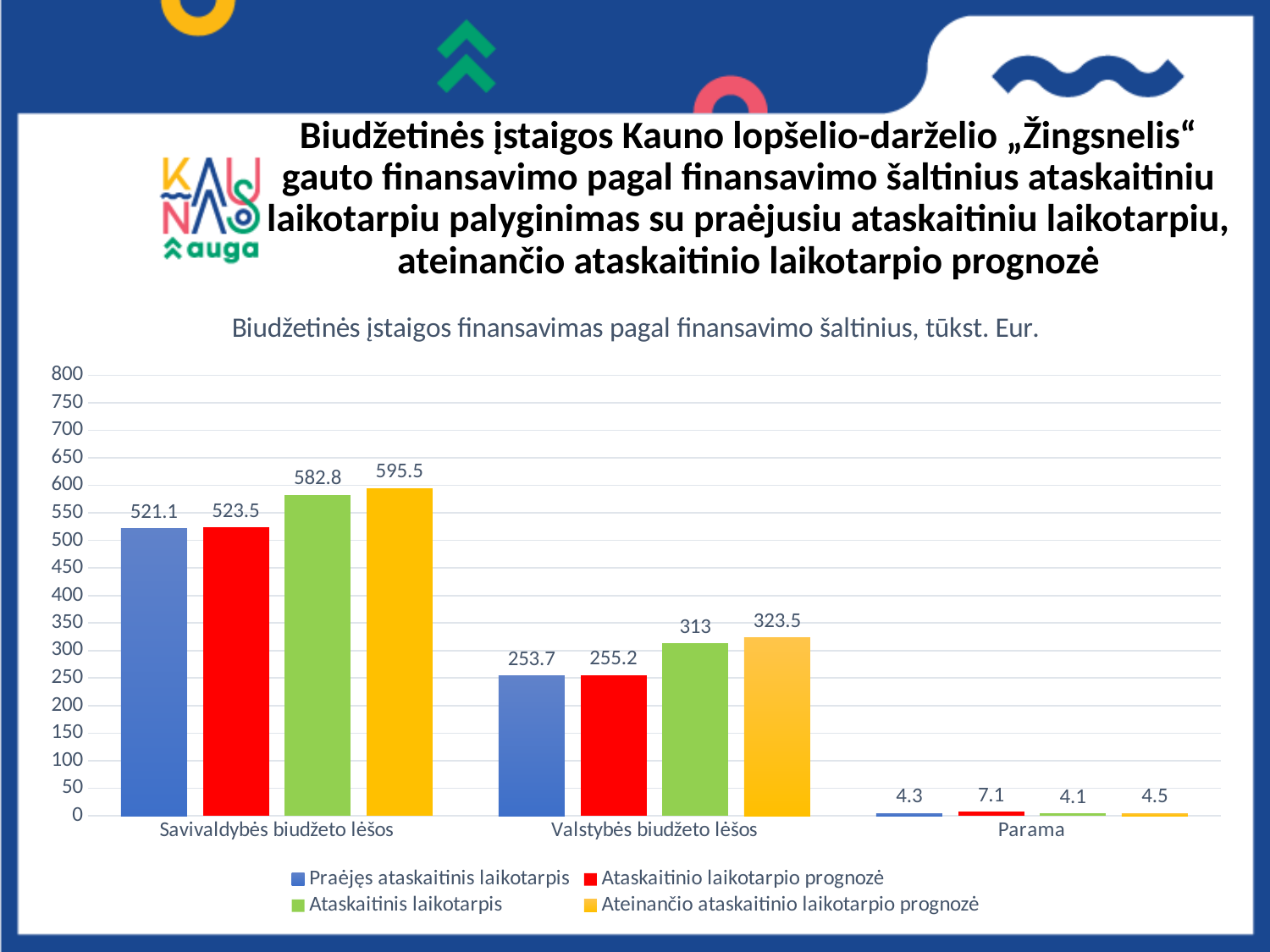
How many categories are shown on the x axis? 3 Which is larger for Parama: the Ataskaitinio laikotarpio prognozė value or the Ataskaitinis laikotarpis value? Ataskaitinio laikotarpio prognozė What is the difference between the Ateinančio ataskaitinio laikotarpio prognozė and Ataskaitinis laikotarpis values for Savivaldybės biudžeto lėšos? 12.7 What is the value for Savivaldybės biudžeto lėšos in the Ataskaitinis laikotarpis series? 582.8 Which category has the lowest value in the Ataskaitinis laikotarpis series? Parama What is the value for Parama in the Ataskaitinio laikotarpio prognozė series? 7.1 Which category has the highest value in the Ateinančio ataskaitinio laikotarpio prognozė series? Savivaldybės biudžeto lėšos How many series does the legend list? 4 What type of chart is shown on the slide? bar chart What is the value for Valstybės biudžeto lėšos in the Ateinančio ataskaitinio laikotarpio prognozė series? 323.5 What is the title of the chart? Biudžetinės įstaigos finansavimas pagal finansavimo šaltinius, tūkst. Eur. What is the value for Valstybės biudžeto lėšos in the Praėjęs ataskaitinis laikotarpis series? 253.7